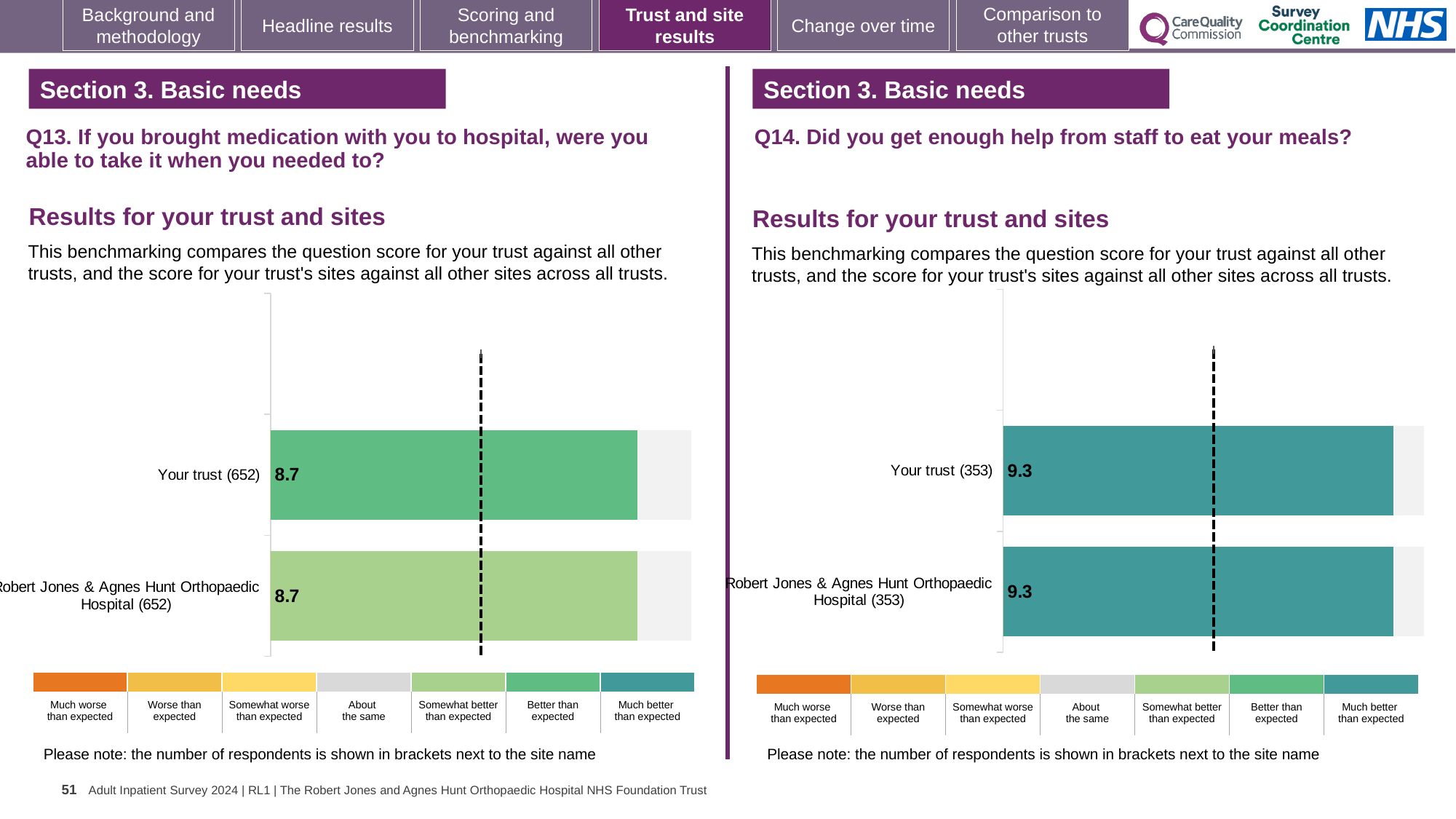
On the Q14 chart (right), how many categories does the colour key below the chart list? 7 On the Q14 chart (right), how many bars are plotted? 2 On the Q13 chart (left), how many bars are plotted? 2 On the Q13 chart (left), what is the difference between the score for Your trust and the score for Robert Jones & Agnes Hunt Orthopaedic Hospital? 0 On the Q14 chart (right), what is the score for Robert Jones & Agnes Hunt Orthopaedic Hospital? 9.3 On the Q14 chart (right), how many respondents are shown in brackets for Robert Jones & Agnes Hunt Orthopaedic Hospital? 353 On the Q13 chart (left), what is the score for Robert Jones & Agnes Hunt Orthopaedic Hospital? 8.7 Is the score for Your trust on the Q14 chart (right) larger or smaller than the score for Your trust on the Q13 chart (left)? Larger On the Q14 chart (right), what is the score for Your trust? 9.3 What kind of chart is used on the Q13 chart (left)? Bar chart On the Q13 chart (left), how many respondents are shown in brackets for Your trust? 652 On the Q13 chart (left), what is the score for Your trust? 8.7